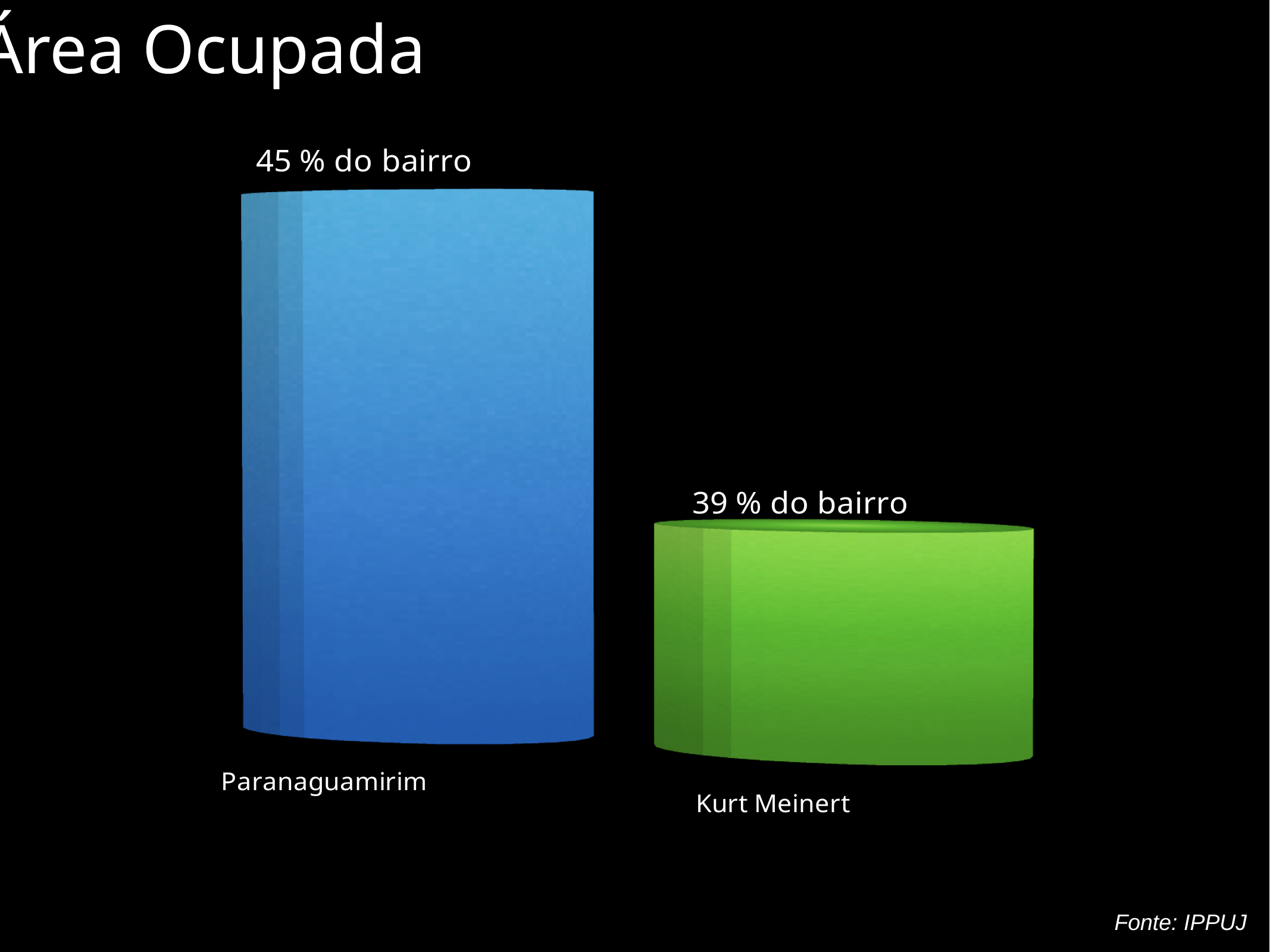
What is the title of the slide? Área Ocupada Which is larger, the value for Paranaguamirim or the value for Kurt Meinert? Paranaguamirim What kind of chart is shown on the slide? bar chart What colour is the bar for Kurt Meinert? green How many categories are shown in the chart? 2 Which category has the highest value? Paranaguamirim What is the difference in percentage points between Paranaguamirim and Kurt Meinert? 6 Which category has the lowest value? Kurt Meinert What is the value shown for Paranaguamirim? 45 % do bairro What is the value shown for Kurt Meinert? 39 % do bairro